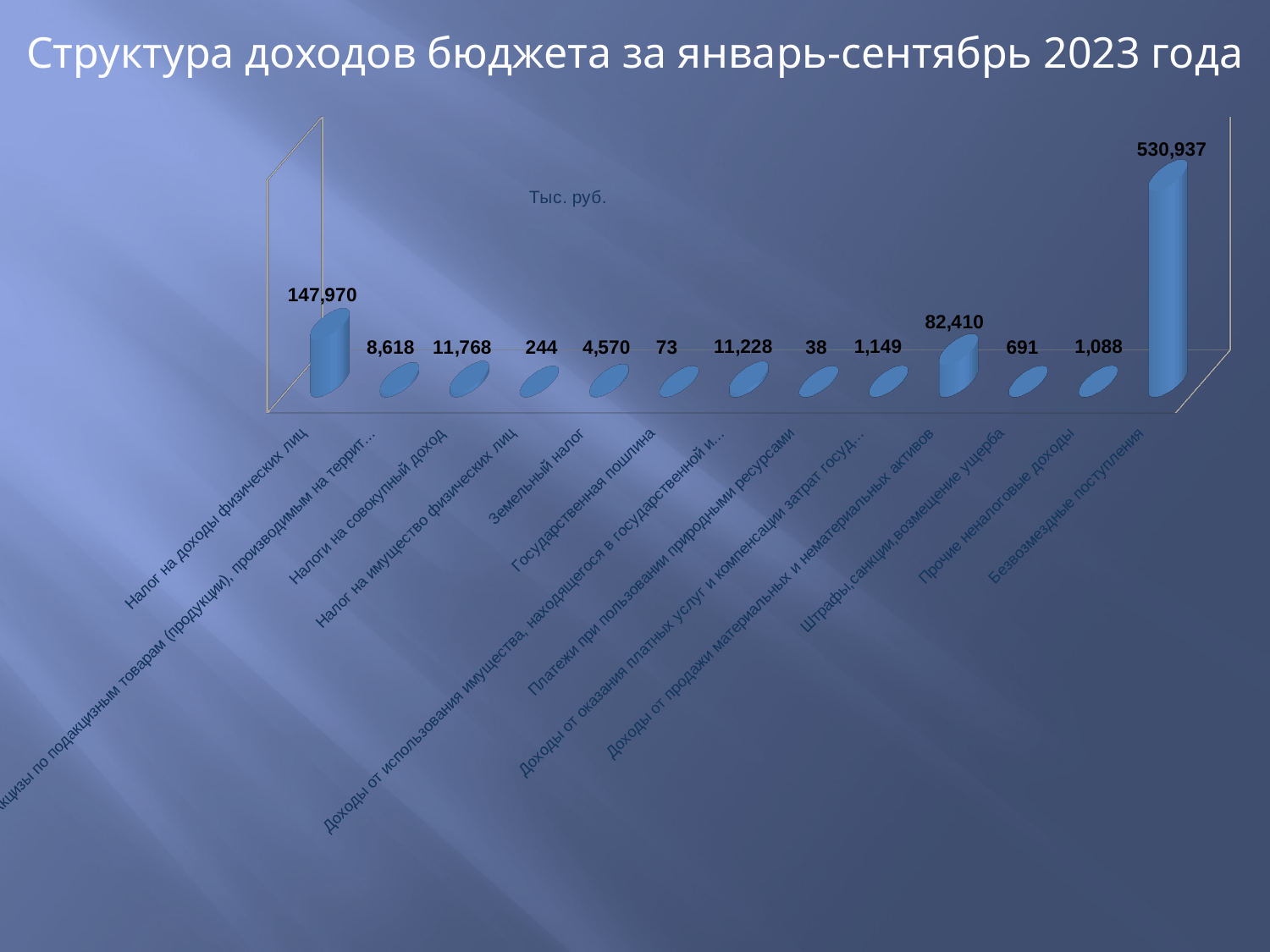
Which category has the highest value? Безвозмездные поступления What kind of chart is shown on the slide? Bar chart What is the value for Безвозмездные поступления? 530,937 What is the difference between the values for Безвозмездные поступления and Налог на доходы физических лиц? 382,967 How many categories are shown in the chart? 13 What is the value for Налог на доходы физических лиц? 147,970 What is the value for Доходы от продажи материальных и нематериальных активов? 82,410 What is the value for Платежи при пользовании природными ресурсами? 38 What is the value for Земельный налог? 4,570 Which category has the lowest value? Платежи при пользовании природными ресурсами What unit label is shown above the chart? Тыс. руб. Which is larger, the value for Налоги на совокупный доход or the value for Государственная пошлина? Налоги на совокупный доход